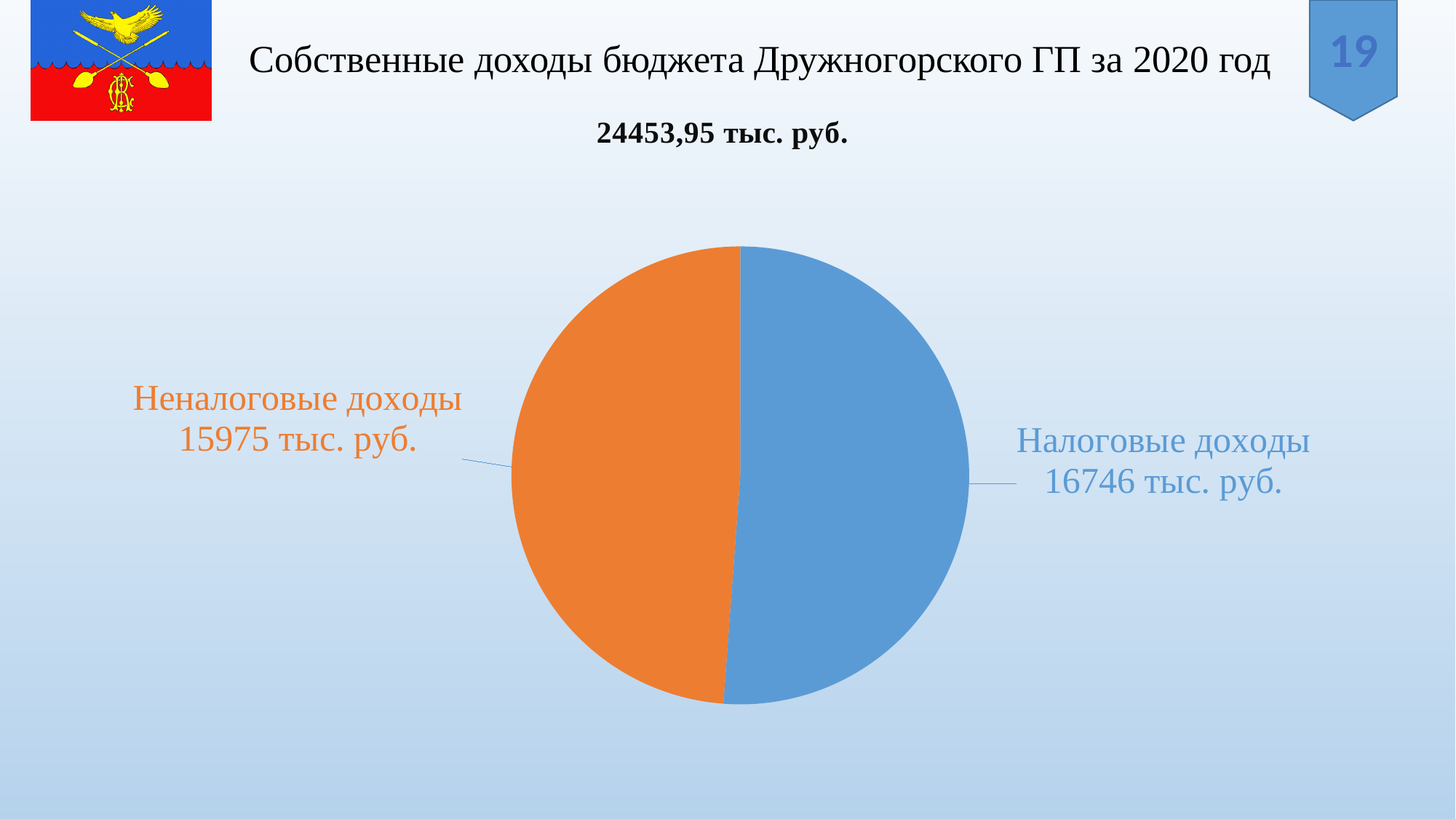
How many slices does the pie chart have? 2 What is the value shown for Неналоговые доходы? 15975 тыс. руб. Which category has the smaller value in the pie chart? Неналоговые доходы Which is larger: Налоговые доходы or Неналоговые доходы? Налоговые доходы What kind of chart is shown on the slide? pie chart What is the title of the slide containing the pie chart? Собственные доходы бюджета Дружногорского ГП за 2020 год What is the difference between Налоговые доходы and Неналоговые доходы? 771 тыс. руб. What colour is the slice for Налоговые доходы? blue What is the value shown for Налоговые доходы? 16746 тыс. руб. Which category has the larger value in the pie chart? Налоговые доходы